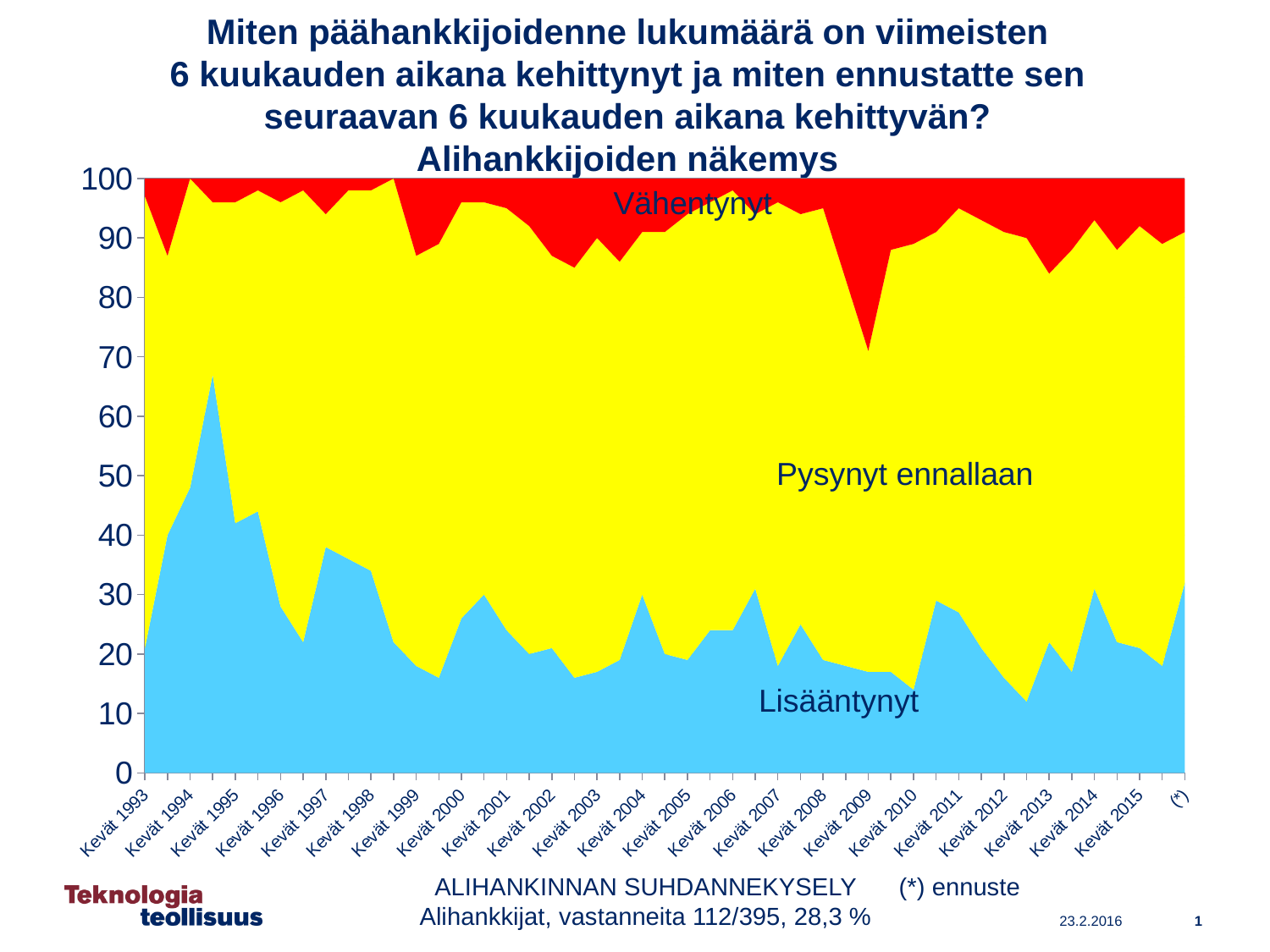
Does the Lisääntynyt series rise or fall from Kevät 1995 to Kevät 1996? Fall Which series is plotted at the bottom of the stack? Lisääntynyt What colour is the Vähentynyt area? Red What kind of chart is shown on the slide? Stacked area chart Is the value for Lisääntynyt at Kevät 2009 greater or less than 20? less How many series are shown in the chart? 3 Which is larger, the Lisääntynyt value at Kevät 1995 or at Kevät 2013? Kevät 1995 At which labeled point is the Vähentynyt area at its largest? Kevät 2009 Is the value for Lisääntynyt at Kevät 1995 greater or less than 60? less